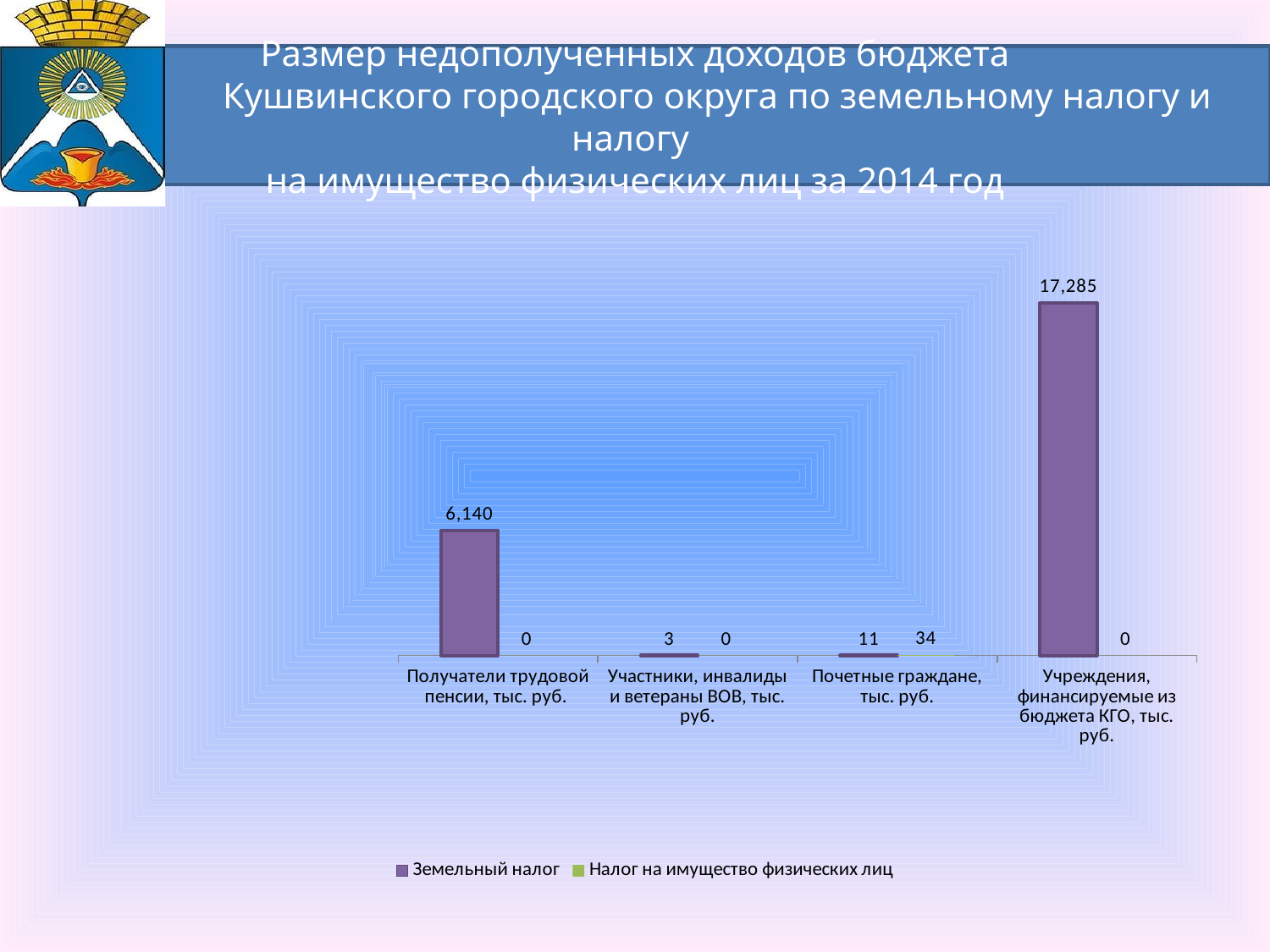
For Почетные граждане, which is larger: Земельный налог or Налог на имущество физических лиц? Налог на имущество физических лиц What is the value of Налог на имущество физических лиц for Почетные граждане, тыс. руб.? 34 What is the value of Земельный налог for Получатели трудовой пенсии, тыс. руб.? 6,140 How many series does the legend list? 2 How many categories are shown on the x axis? 4 What is the difference between the Земельный налог values for Учреждения, финансируемые из бюджета КГО and Получатели трудовой пенсии? 11,145 What kind of chart is shown on the slide? Bar chart Which series is shown in purple according to the legend? Земельный налог Which category has the highest value of Земельный налог? Учреждения, финансируемые из бюджета КГО, тыс. руб. What is the value of Земельный налог for Участники, инвалиды и ветераны ВОВ, тыс. руб.? 3 Which category has the lowest value of Земельный налог? Участники, инвалиды и ветераны ВОВ, тыс. руб. What is the value of Земельный налог for Учреждения, финансируемые из бюджета КГО, тыс. руб.? 17,285